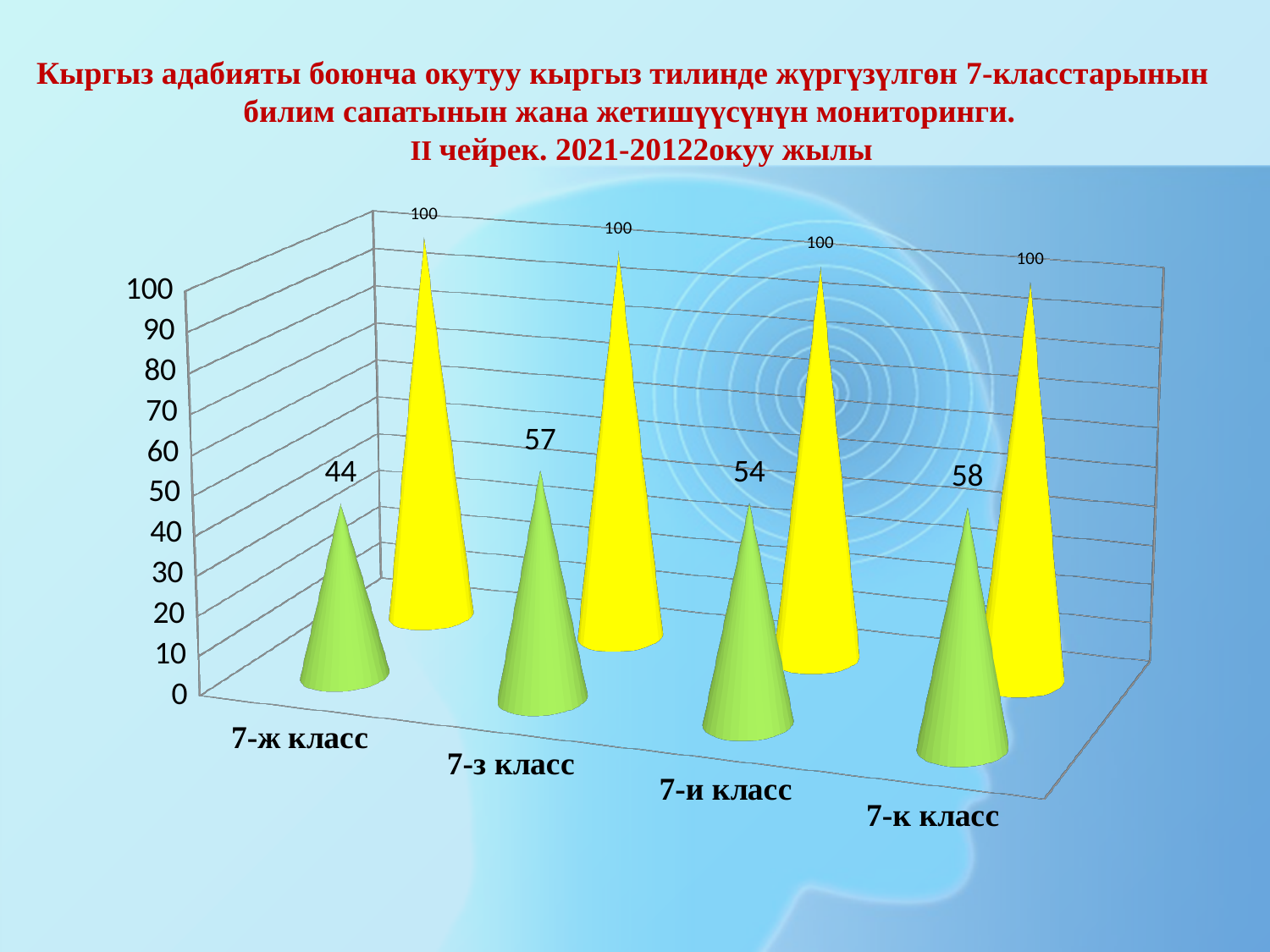
Is the green bar value for 7-ж класс greater or less than 50? less What is the difference between the green bar values for 7-к класс and 7-ж класс? 14 What is the value of the green bar for 7-ж класс? 44 Which class has the highest green bar value? 7-к класс Which class has the lowest green bar value? 7-ж класс What is the value of the yellow bar for 7-к класс? 100 What value do all the yellow bars share? 100 What is the value of the green bar for 7-и класс? 54 Which is larger: the green bar value for 7-з класс or for 7-и класс? 7-з класс What is the value of the green bar for 7-з класс? 57 What kind of chart is shown on the slide? bar chart How many classes are shown on the x axis of the chart? 4